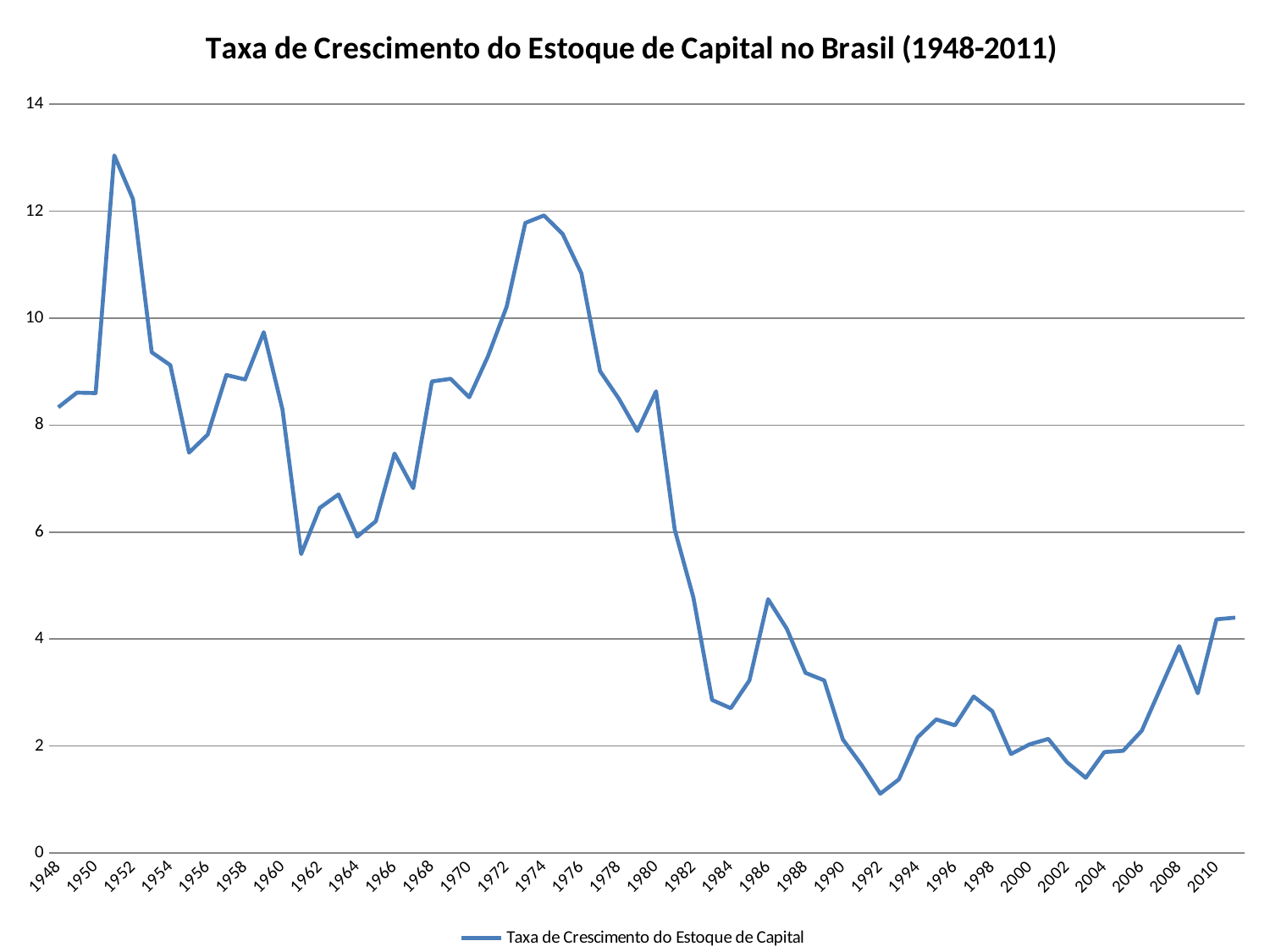
How many series does the legend list? 1 Is the value for 1961 greater or less than 6? less Which year has the higher value, 1980 or 1984? 1980 Is the value for 1948 greater or less than 8? greater Which year has the higher value, 1951 or 1974? 1951 Does the growth rate rise or fall between 1974 and 1984? fall In which year does the growth rate of the capital stock reach its highest value? 1951 In which year does the growth rate of the capital stock reach its lowest value? 1992 What kind of chart is shown on the slide? line chart What is the title of the chart? Taxa de Crescimento do Estoque de Capital no Brasil (1948-2011) Is the value for 2003 greater or less than 2? less